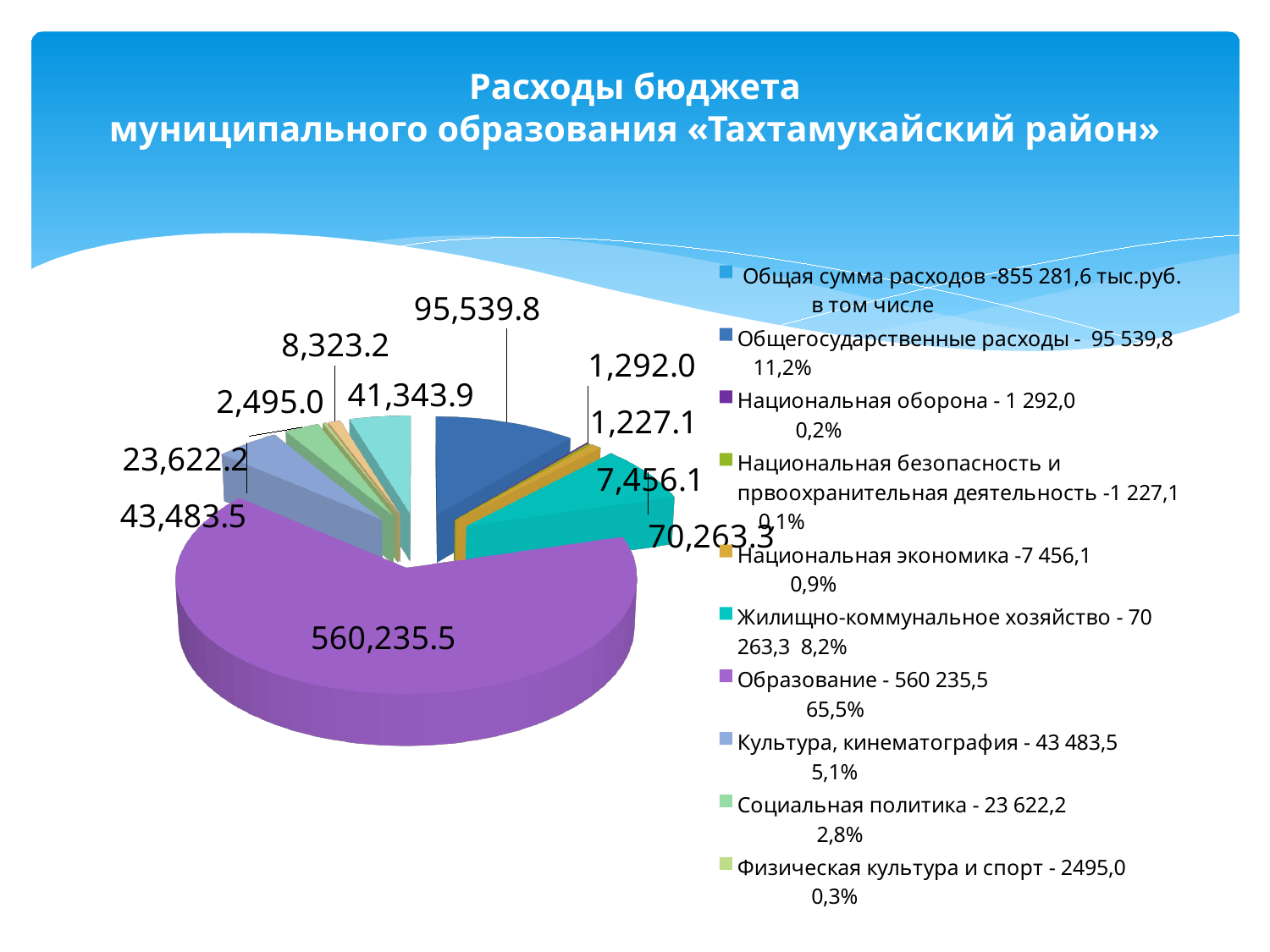
Which category has the smallest value in the chart? Национальная безопасность и правоохранительная деятельность What is the value shown for Образование? 560,235.5 How many slices with data labels does the pie chart have? 11 What is the value shown for Общегосударственные расходы? 95,539.8 Which is larger: Жилищно-коммунальное хозяйство or Культура, кинематография? Жилищно-коммунальное хозяйство What share of the pie does Образование account for, according to the legend? 65,5% What is the total sum of expenditures stated in the legend? 855 281,6 тыс.руб. What kind of chart is shown on the slide? pie chart Which category has the largest slice of the pie? Образование What is the value shown for Социальная политика? 23,622.2 What percentage share does Культура, кинематография have, according to the legend? 5,1% What is the difference between the values for Общегосударственные расходы and Жилищно-коммунальное хозяйство? 25,276.5